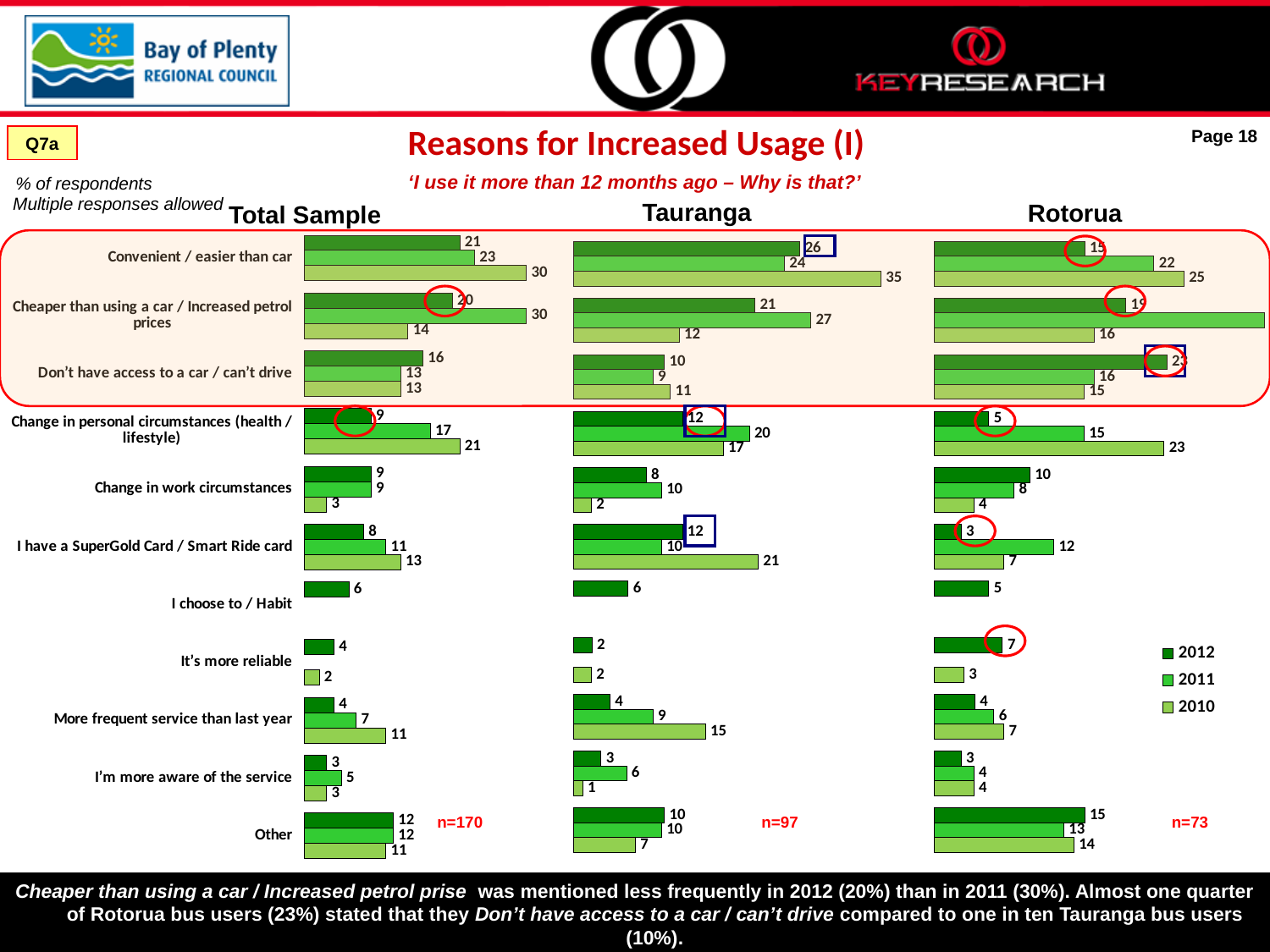
What type of chart is used on this slide? Bar chart In the Tauranga chart, what is the 2010 value for 'More frequent service than last year'? 15 In the Total Sample chart, what is the difference between the 2011 and 2012 values for 'Cheaper than using a car / Increased petrol prices'? 10 In the Tauranga chart, what is the 2012 value for 'Convenient / easier than car'? 26 In the Rotorua chart, which is larger for 'Change in personal circumstances (health / lifestyle)': the 2012 value or the 2010 value? 2010 How many series does the legend list? 3 In the Tauranga chart, which year has the highest value for 'I have a SuperGold Card / Smart Ride card'? 2010 In the Rotorua chart, what is the 2012 value for 'It's more reliable'? 7 In the Rotorua chart, what is the 2012 value for 'Don't have access to a car / can't drive'? 23 In the Total Sample chart, what is the 2010 value for 'Convenient / easier than car'? 30 What is the sample size (n) shown for the Tauranga chart? n=97 In the Total Sample chart, what is the 2011 value for 'Other'? 12